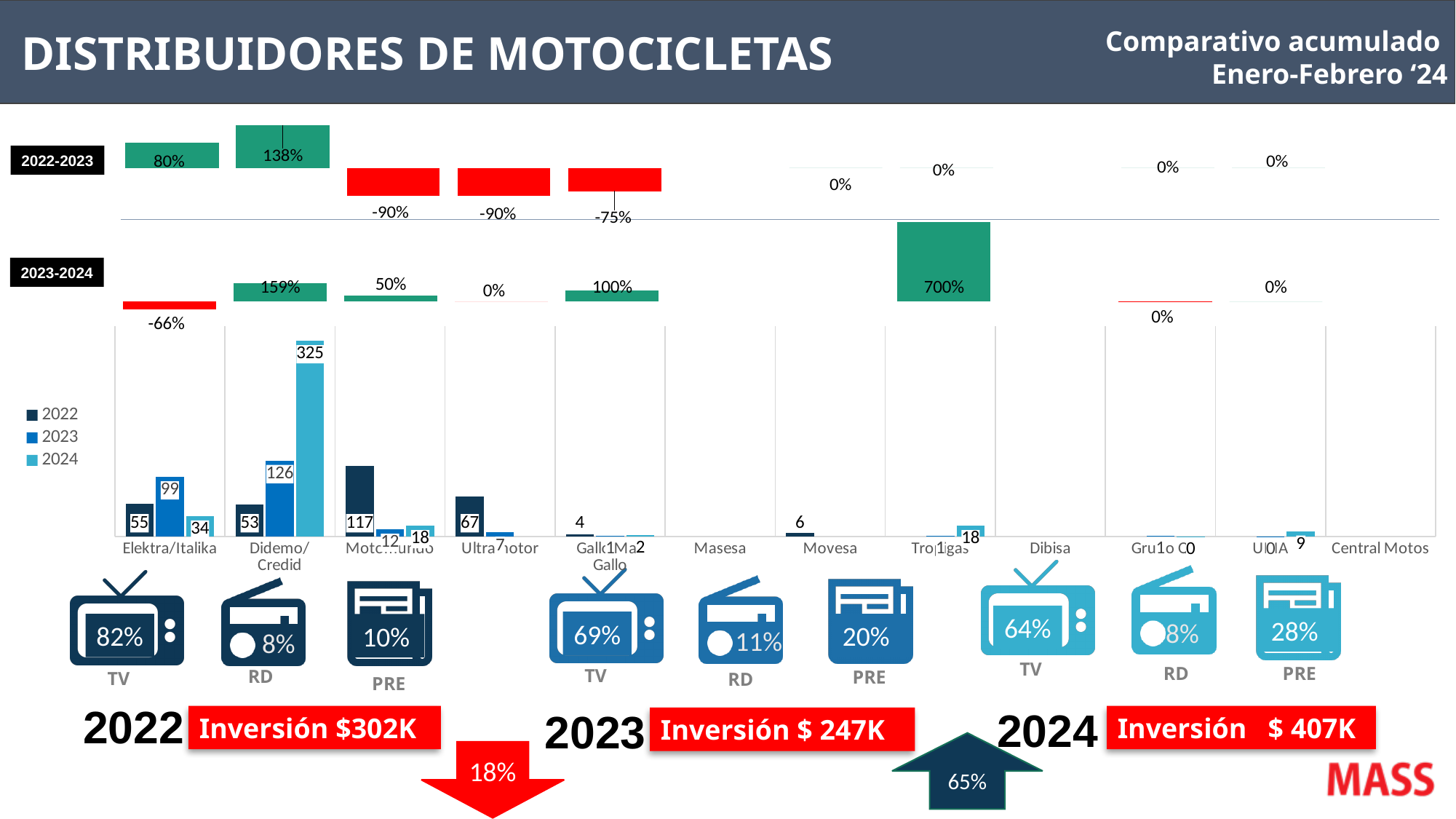
In the bar chart, what is the 2023 value for Elektra/Italika? 99 In the bar chart, which is larger for Elektra/Italika: the 2022 value or the 2024 value? 2022 In the bar chart, what is the 2022 value for Ultramotor? 67 In the 2023-2024 change chart, what is the percentage for Tropigas? 700% What kind of chart is the main chart showing values by distributor? bar chart In the bar chart, which distributor has the highest 2024 value? Didemo/Credid In the bar chart, what is the difference between the 2023 and 2022 values for Didemo/Credid? 73 In the 2023-2024 change chart, what is the percentage for Elektra/Italika? -66% In the bar chart, what is the 2024 value for Didemo/Credid? 325 In the 2022-2023 change chart, what is the percentage for Didemo/Credid? 138% In the bar chart, what is the 2022 value for Motomundo? 117 How many series does the legend of the bar chart list? 3